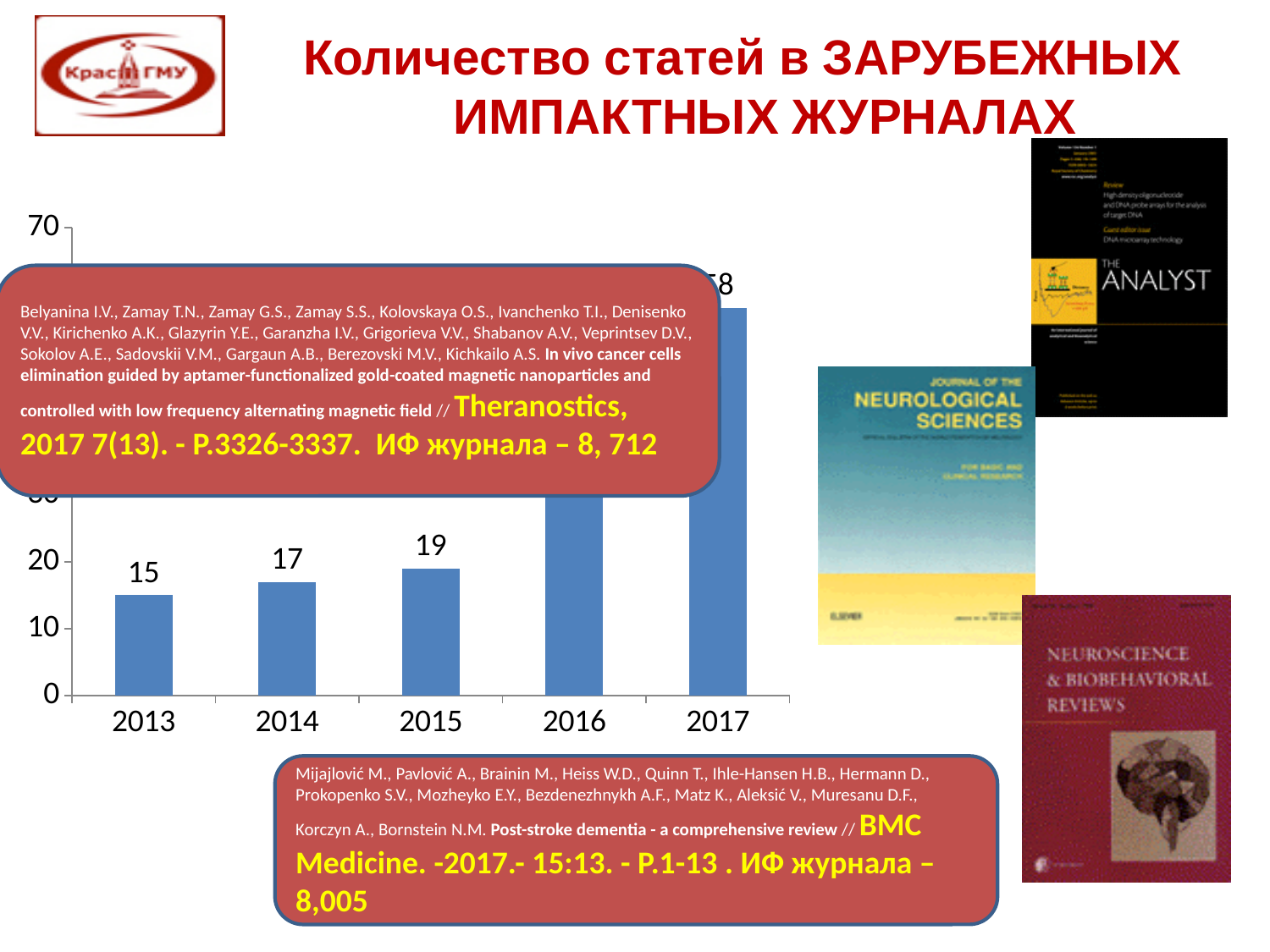
What is the value for 2013? 15 Which year has the lowest value? 2013 Do the values rise or fall from 2013 to 2017? rise What kind of chart is shown on the slide? bar chart What is the difference between the values for 2014 and 2013? 2 What is the difference between the values for 2015 and 2013? 4 Which is larger, the value for 2016 or the value for 2015? 2016 Is the value for 2017 greater or less than 20? greater What is the value for 2014? 17 What is the value for 2015? 19 Which year has the highest value? 2017 How many years are shown on the x axis? 5